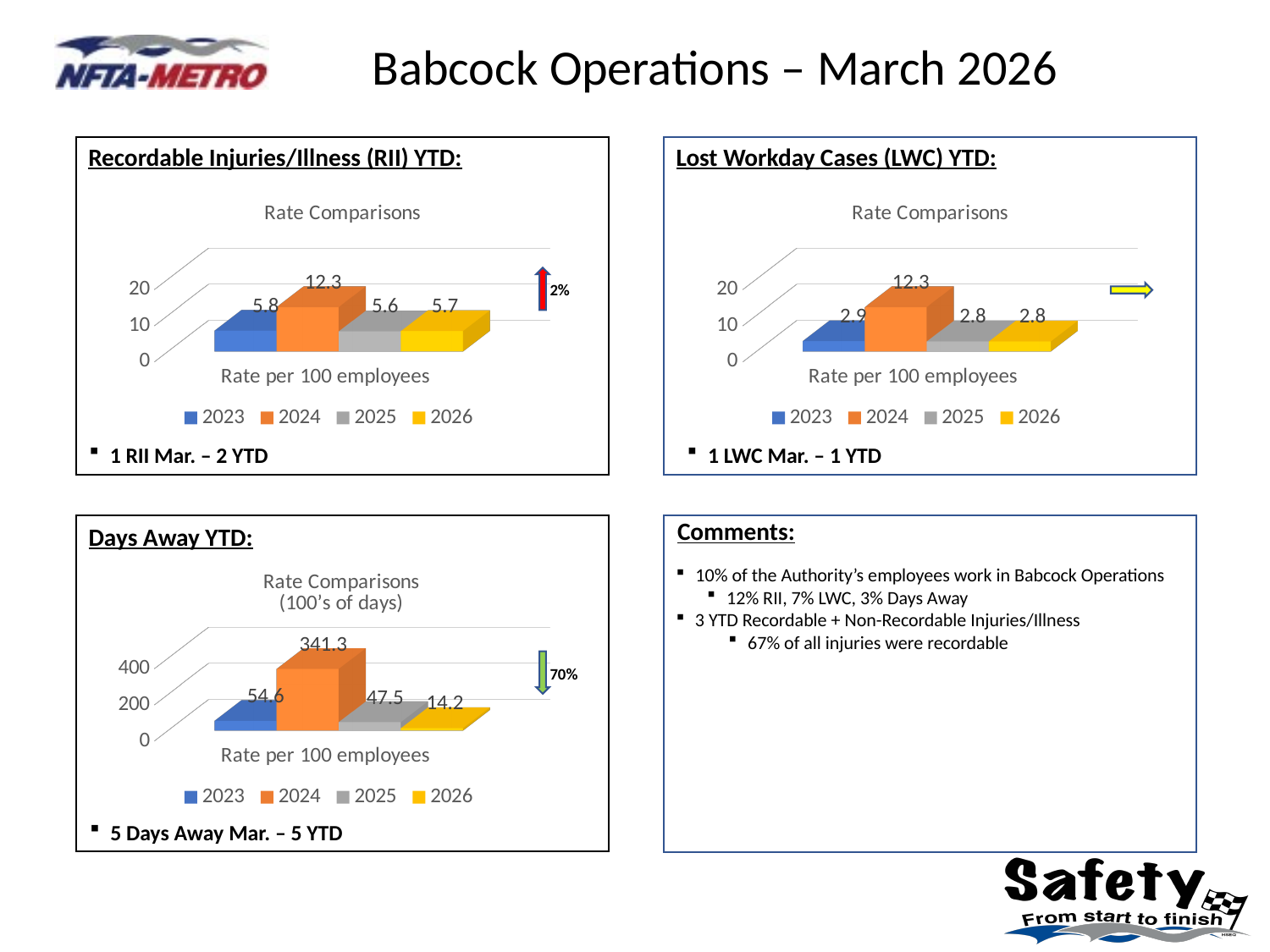
In the Days Away YTD chart, which year has the lowest value? 2026 In the Days Away YTD chart, what is the difference between the 2023 and 2026 values? 40.4 What kind of chart is the Days Away YTD chart? bar chart In the Recordable Injuries/Illness (RII) YTD chart, which year has the highest rate? 2024 In the Days Away YTD chart, is the value for 2023 larger or smaller than the value for 2025? larger In the Recordable Injuries/Illness (RII) YTD chart, what is the difference between the 2024 and 2025 values? 6.7 In the Lost Workday Cases (LWC) YTD chart, what is the value for 2023? 2.9 In the Recordable Injuries/Illness (RII) YTD chart, what is the value for 2026? 5.7 In the Lost Workday Cases (LWC) YTD chart, how many series does the legend list? 4 In the Days Away YTD chart, what is the value for 2024? 341.3 In the Recordable Injuries/Illness (RII) YTD chart, what is the value for 2024? 12.3 In the Lost Workday Cases (LWC) YTD chart, which year has the highest rate? 2024